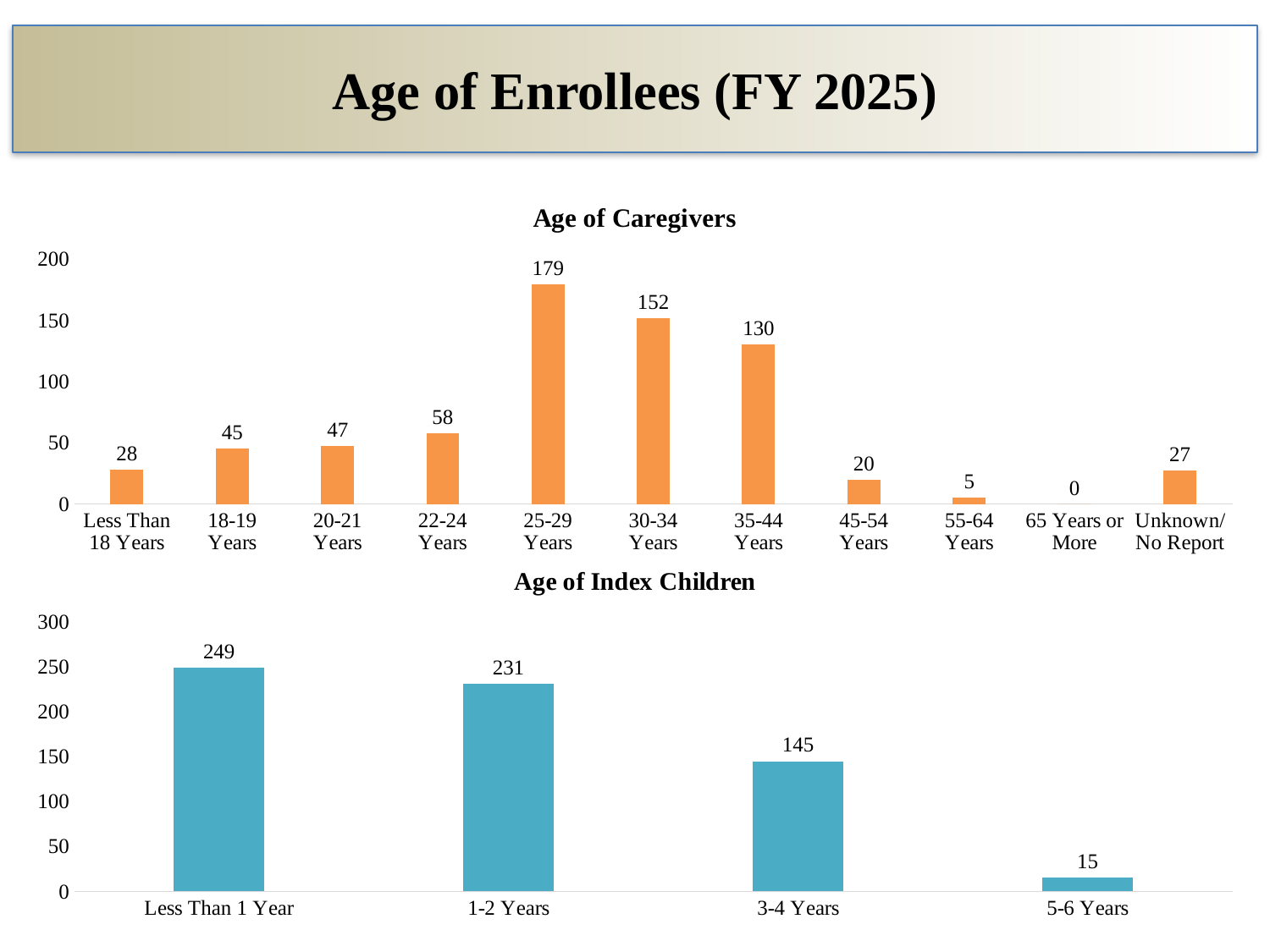
In the 'Age of Index Children' chart, what is the value for 3-4 Years? 145 In the 'Age of Caregivers' chart, which is larger, the value for 18-19 Years or the value for 20-21 Years? 20-21 Years In the 'Age of Caregivers' chart, which age group has the highest value? 25-29 Years In the 'Age of Caregivers' chart, what is the difference between the values for 30-34 Years and 35-44 Years? 22 In the 'Age of Index Children' chart, which category has the highest value? Less Than 1 Year In the 'Age of Index Children' chart, do the values rise or fall from left to right along the x axis? fall What kind of chart is the 'Age of Index Children' chart? bar chart In the 'Age of Caregivers' chart, what is the value for Unknown/No Report? 27 In the 'Age of Caregivers' chart, what is the value for 25-29 Years? 179 In the 'Age of Caregivers' chart, which age group has the lowest value? 65 Years or More In the 'Age of Index Children' chart, what is the difference between the values for Less Than 1 Year and 1-2 Years? 18 In the 'Age of Caregivers' chart, how many age categories are shown? 11